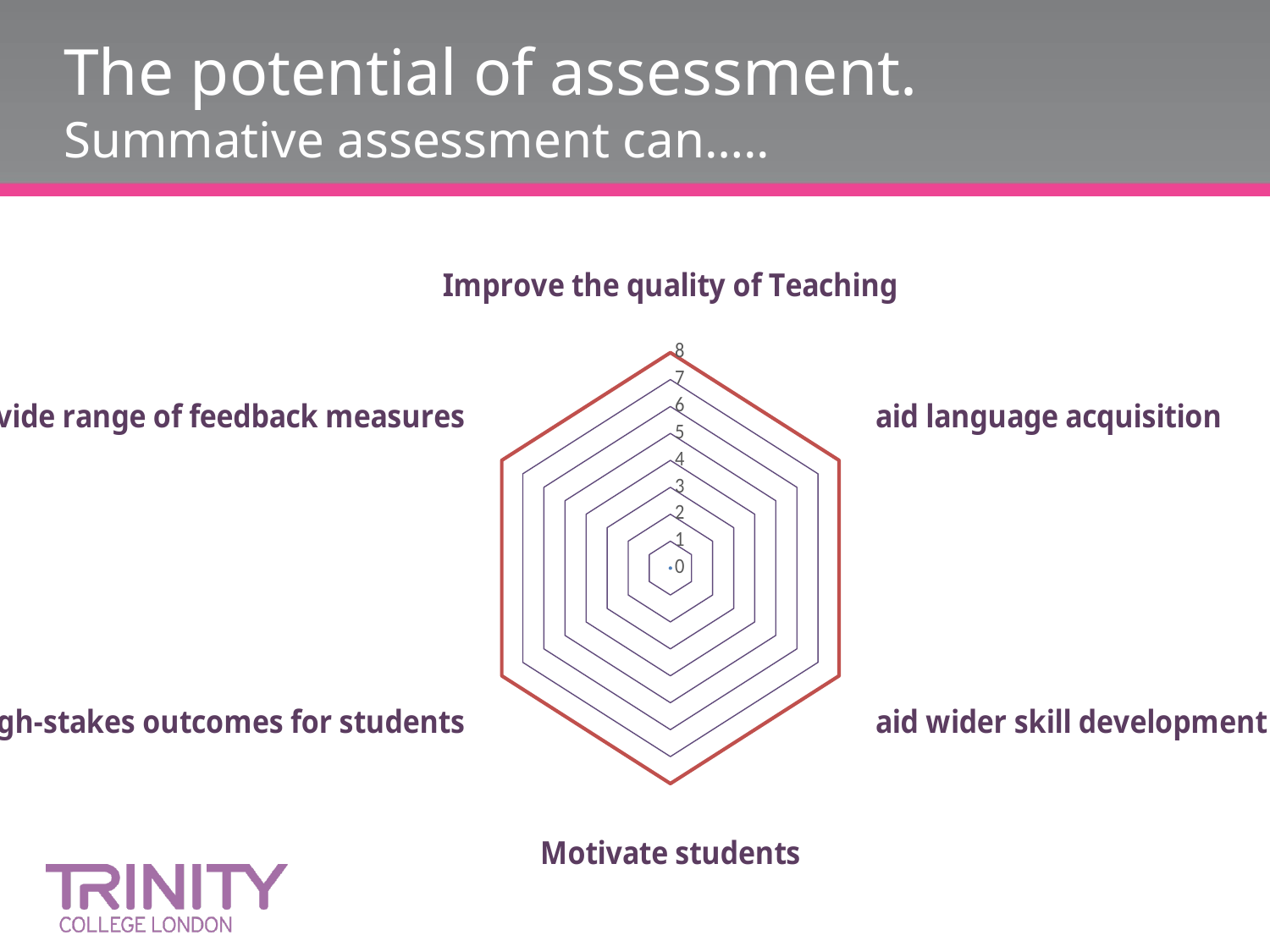
What is the highest tick value shown on the radar chart's axis? 8 What is the value plotted for "Improve the quality of Teaching"? 8 What is the value plotted for "aid wider skill development"? 8 What is the value plotted for "aid language acquisition"? 8 Which category label appears at the top of the radar chart? Improve the quality of Teaching What is the difference between the values for "Improve the quality of Teaching" and "Motivate students"? 0 What is the value plotted for "Motivate students"? 8 Is the value for "Motivate students" greater or less than 4? greater How many categories (axes) does the radar chart have? 6 Is the value for "aid language acquisition" greater or less than 5? greater What colour is the plotted data line on the radar chart? red What kind of chart is shown on the slide? radar chart